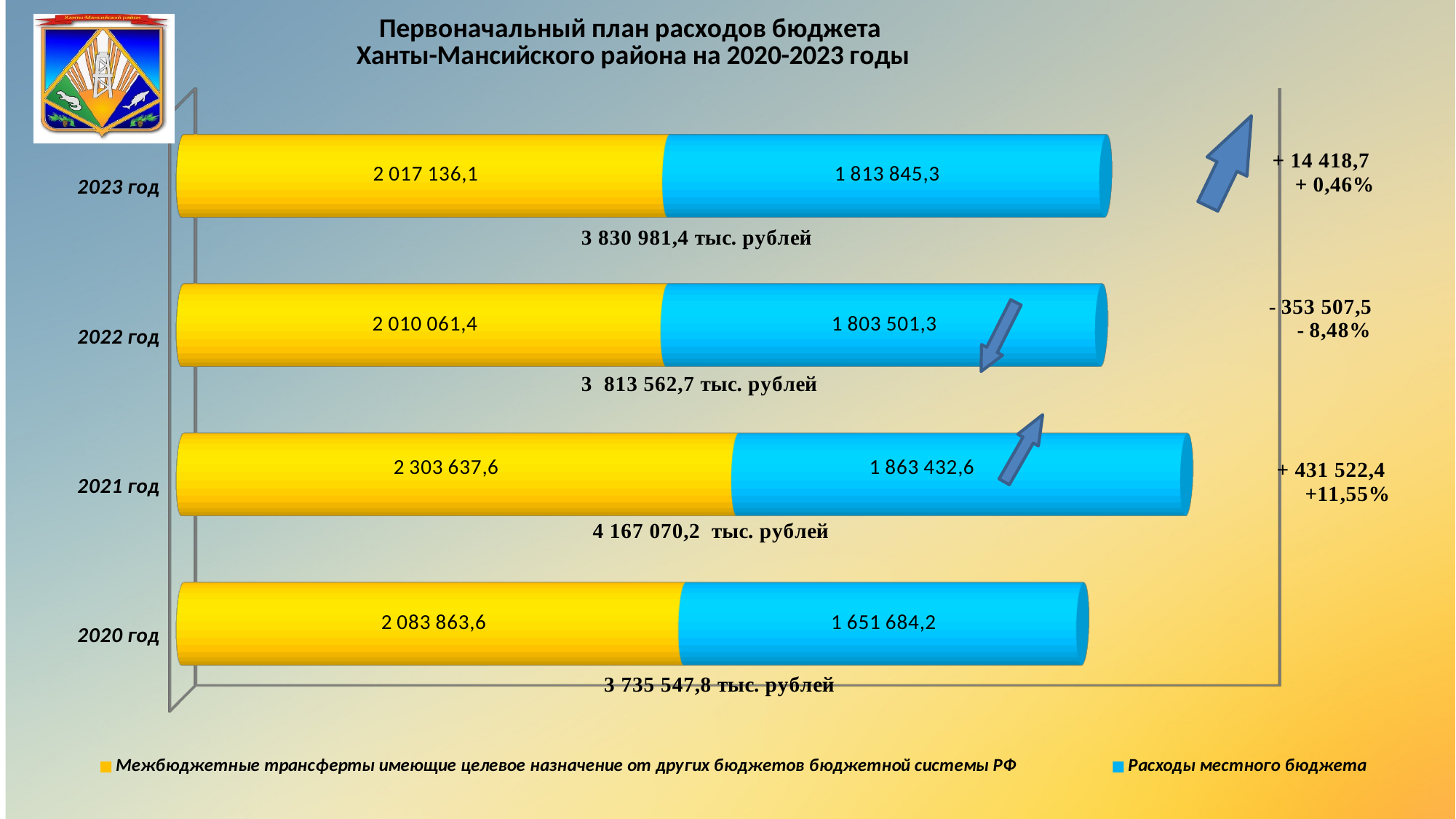
What is the difference between the Межбюджетные трансферты values for 2021 год and 2020 год? 219 774,0 What is the value of Расходы местного бюджета for 2021 год? 1 863 432,6 What is the value of Межбюджетные трансферты for 2022 год? 2 010 061,4 What is the value of Расходы местного бюджета for 2020 год? 1 651 684,2 What is the value of Межбюджетные трансферты for 2023 год? 2 017 136,1 How many series does the legend list? 2 How many years are shown in the chart? 4 What is the total of the stacked bar for 2020 год? 3 735 547,8 тыс. рублей Which year has the lowest value for Расходы местного бюджета? 2020 год What is the total of the stacked bar for 2021 год? 4 167 070,2 тыс. рублей Which is larger: Расходы местного бюджета for 2023 год or for 2022 год? 2023 год Which year has the highest value for Межбюджетные трансферты? 2021 год